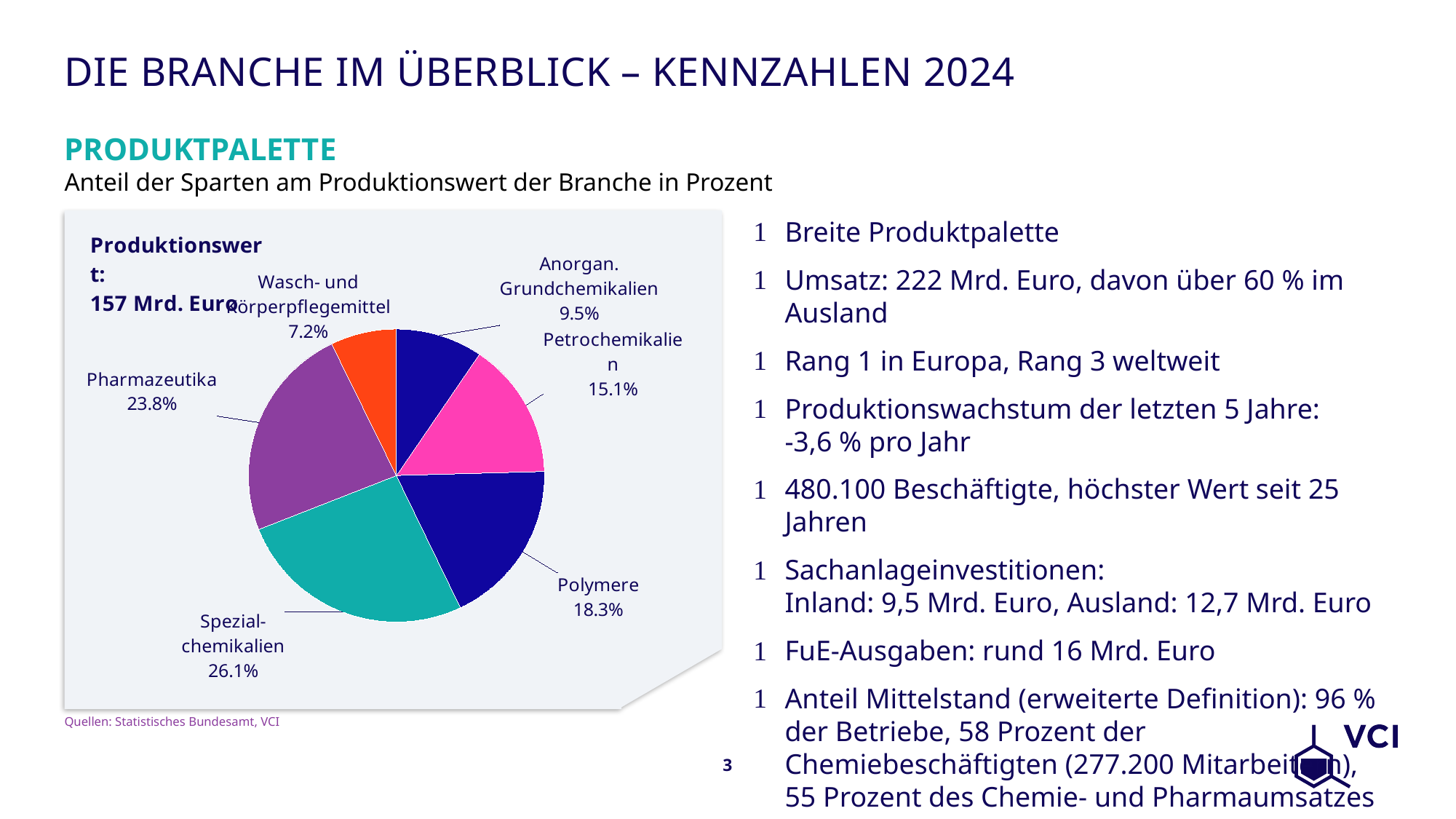
Which segment has the smallest share in the pie chart? Wasch- und Körperpflegemittel How many slices does the pie chart have? 6 Which has a larger share, Pharmazeutika or Petrochemikalien? Pharmazeutika What share of the production value do Spezialchemikalien account for? 26.1% What is the share of Wasch- und Körperpflegemittel? 7.2% What is the difference in percentage points between Polymere and Anorgan. Grundchemikalien? 8.8 What kind of chart is shown on the slide? pie chart What is the combined share of Polymere and Petrochemikalien? 33.4% Which segment has the largest share of the production value? Spezialchemikalien What is the share for Pharmazeutika in the pie chart? 23.8% What total production value (Produktionswert) is stated in the chart? 157 Mrd. Euro What percentage is shown for Petrochemikalien? 15.1%